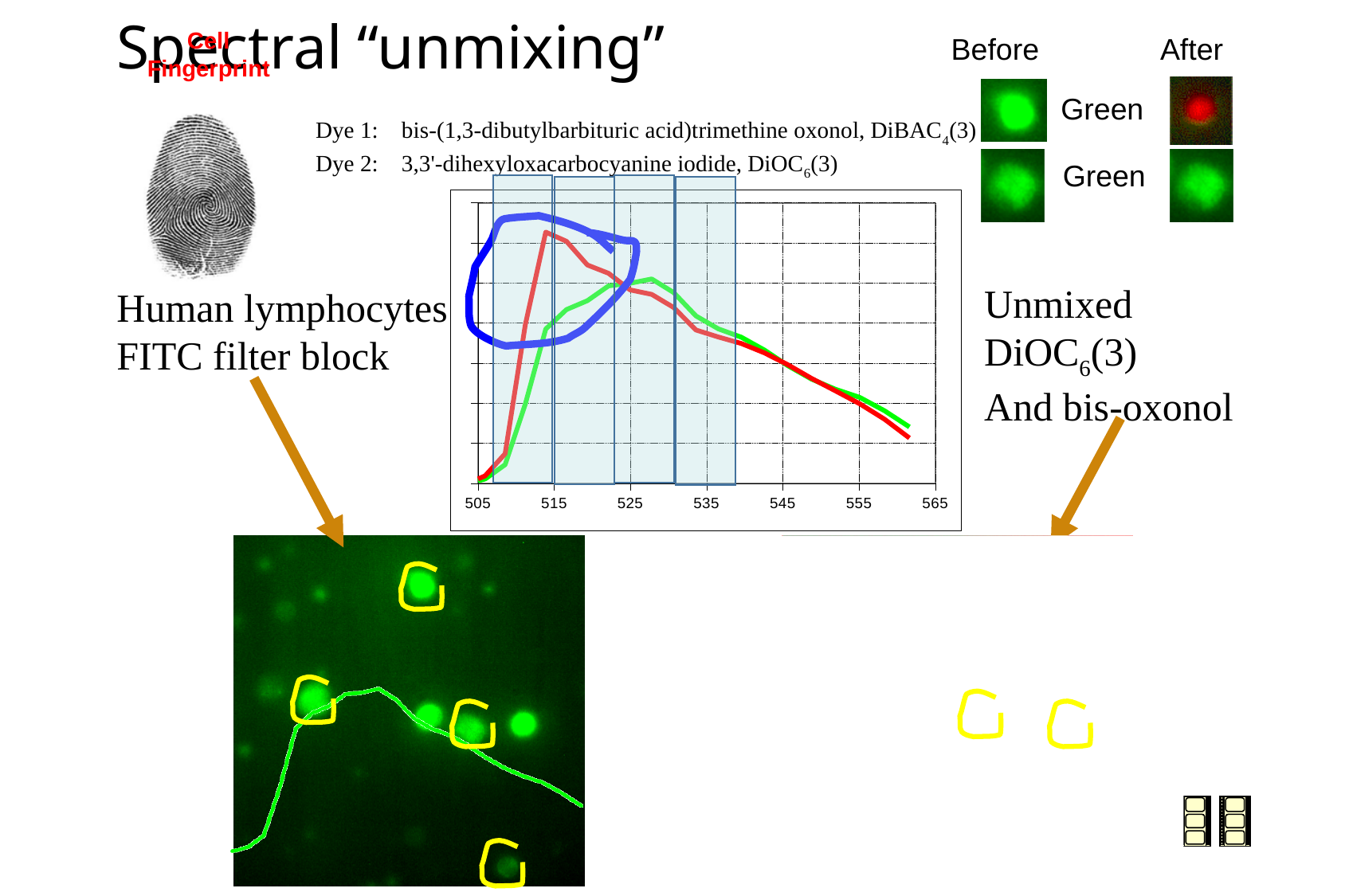
What colour is the hand-drawn loop circling the peaks on the spectral chart? blue What kind of chart is shown in the centre of the slide? line chart How many shaded vertical bands are overlaid on the spectral chart? 4 On the spectral chart, which line is higher at 530, the red line or the green line? green line What is the lowest value labelled on the x axis of the spectral chart? 505 How many tick labels are shown on the x axis of the spectral chart? 7 On the spectral chart, which line reaches its peak at a shorter wavelength, the red line or the green line? red line On the spectral chart, does the red line rise or fall between 505 and 515? rise On the spectral chart, do the red and green lines rise or fall between 545 and 565? fall On the spectral chart, which line is higher at 515, the red line or the green line? red line What is the highest value labelled on the x axis of the spectral chart? 565 How many lines are plotted on the spectral chart? 2